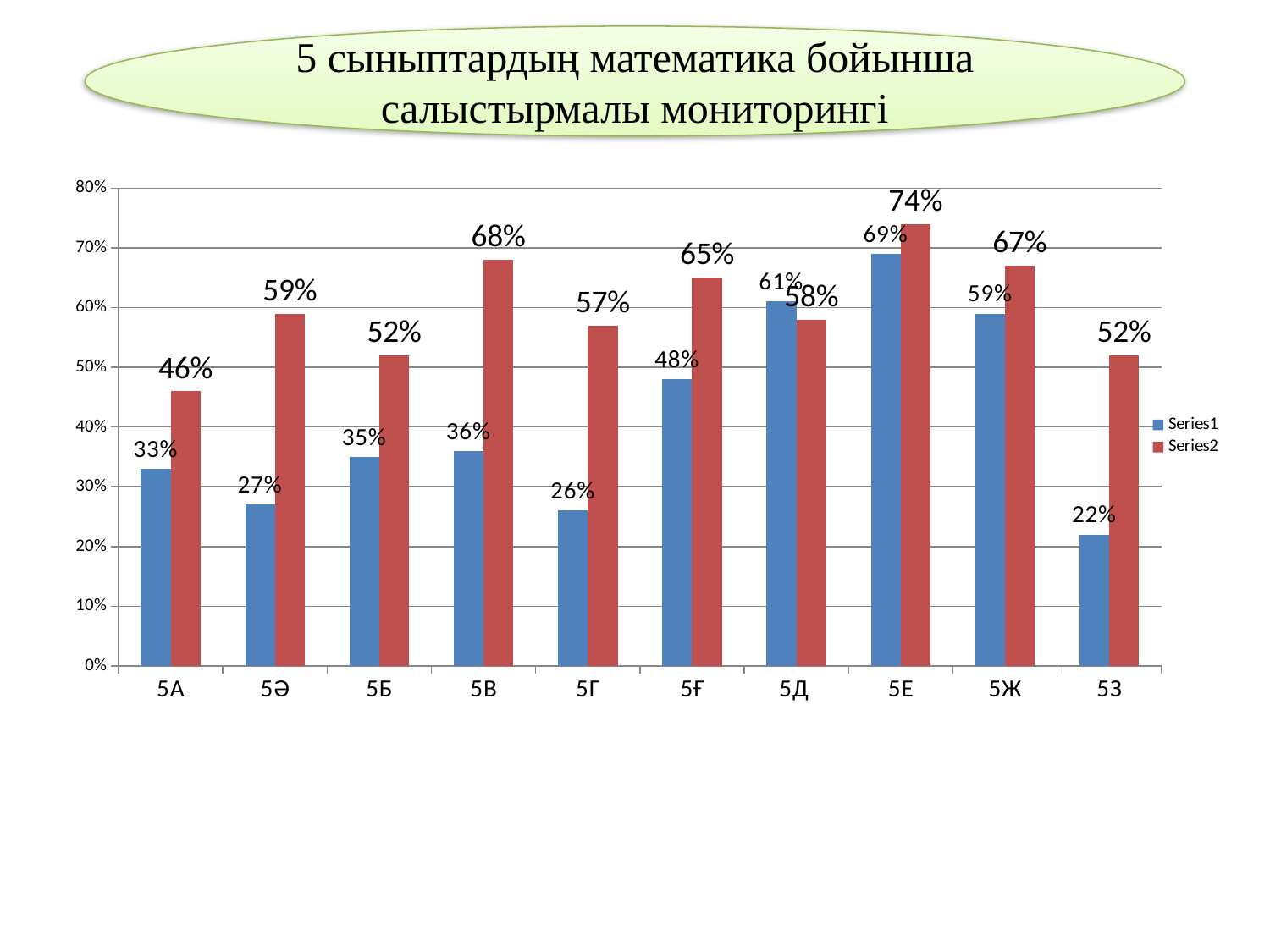
What is the Series1 value for 5Г? 26% What is the difference between the Series2 and Series1 values for 5Ә? 32% What colour are the Series2 bars? red How many categories are shown on the x axis? 10 Is the Series1 value for 5Ғ greater or less than 50%? less What is the Series2 value for 5В? 68% Which category has the lowest Series1 value? 5З Which category has the highest Series2 value? 5Е Which is larger for 5Д: the Series1 value or the Series2 value? Series1 How many series does the legend list? 2 What is the Series1 value for 5Е? 69% What kind of chart is shown on the slide? bar chart